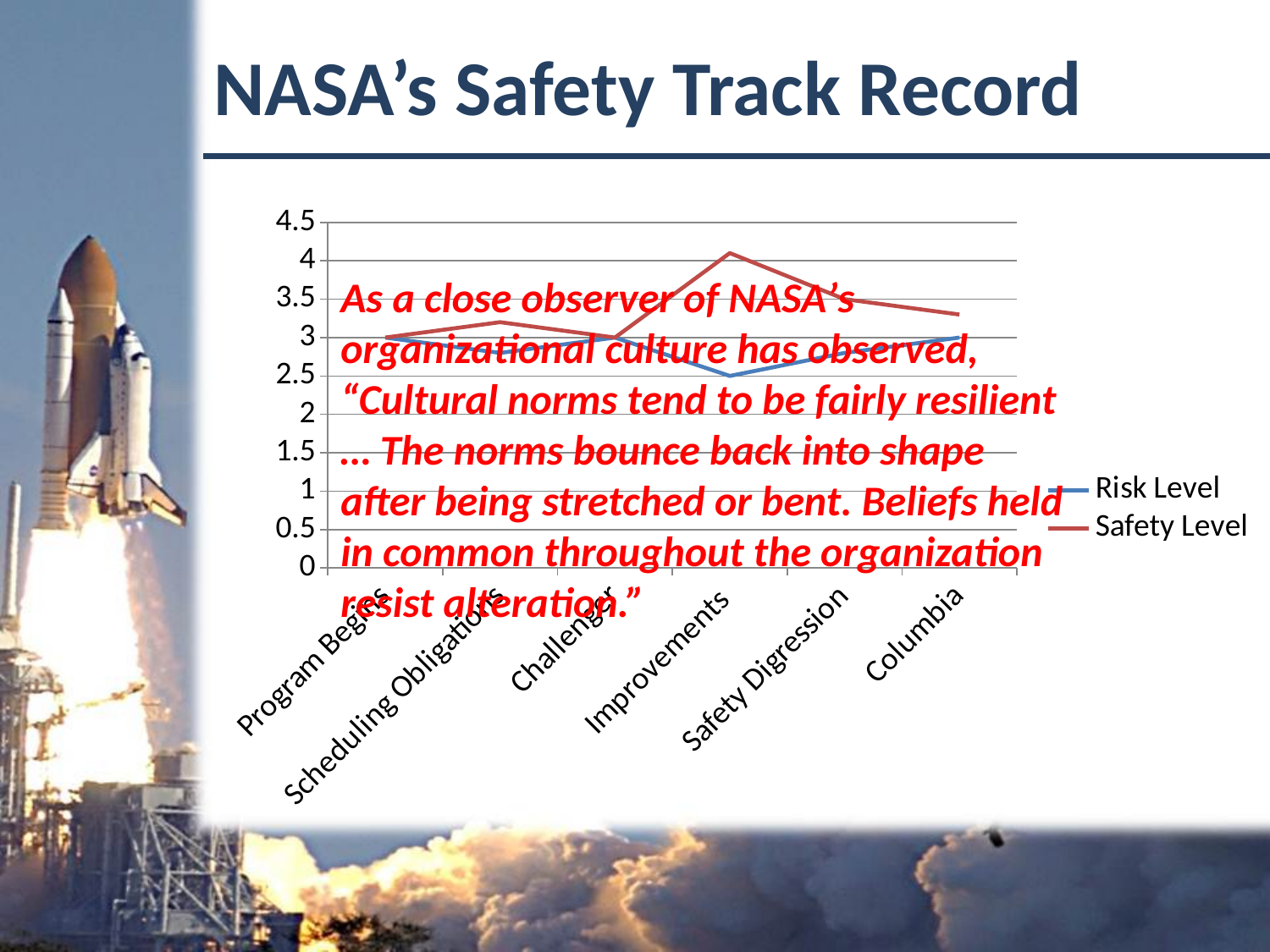
At the Improvements category, which series has the higher value, Risk Level or Safety Level? Safety Level Is the Safety Level value at Columbia greater or less than 3? greater At which category does the Risk Level series reach its lowest value? Improvements Which series is drawn in red on the chart? Safety Level What are the two series named in the chart legend? Risk Level and Safety Level How many categories are shown along the x axis of the chart? 6 Is the Risk Level value at Improvements greater or less than 3? less What is the highest value shown on the chart's y axis? 4.5 How many series does the chart legend list? 2 At which category does the Safety Level series reach its highest value? Improvements Is the Safety Level value at Improvements greater or less than 3.5? greater What kind of chart is shown on the slide? line chart